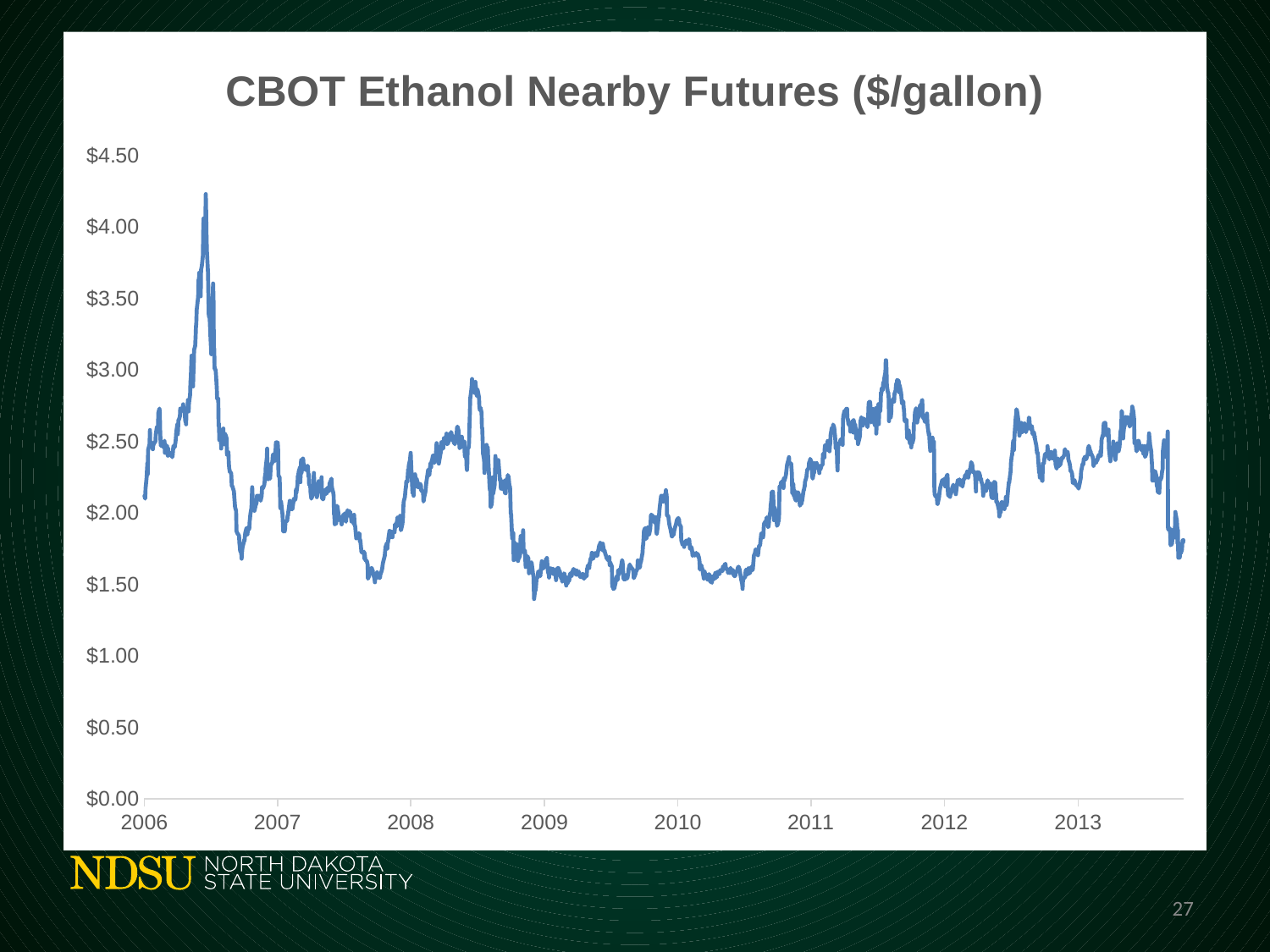
Is the peak value reached in 2006 greater or less than $4.00? greater Does the line rise or fall from mid-2010 to mid-2011? rise Is the lowest value in 2010 greater or less than $2.00? less How many year labels are shown on the x axis? 8 In which year does the line reach its highest value? 2006 What is the title of the chart? CBOT Ethanol Nearby Futures ($/gallon) What kind of chart is shown on the slide? line chart Is the highest value reached in 2008 greater or less than $2.50? greater Does the line rise or fall from the 2006 peak to the start of 2007? fall What is the highest value labelled on the y axis? $4.50